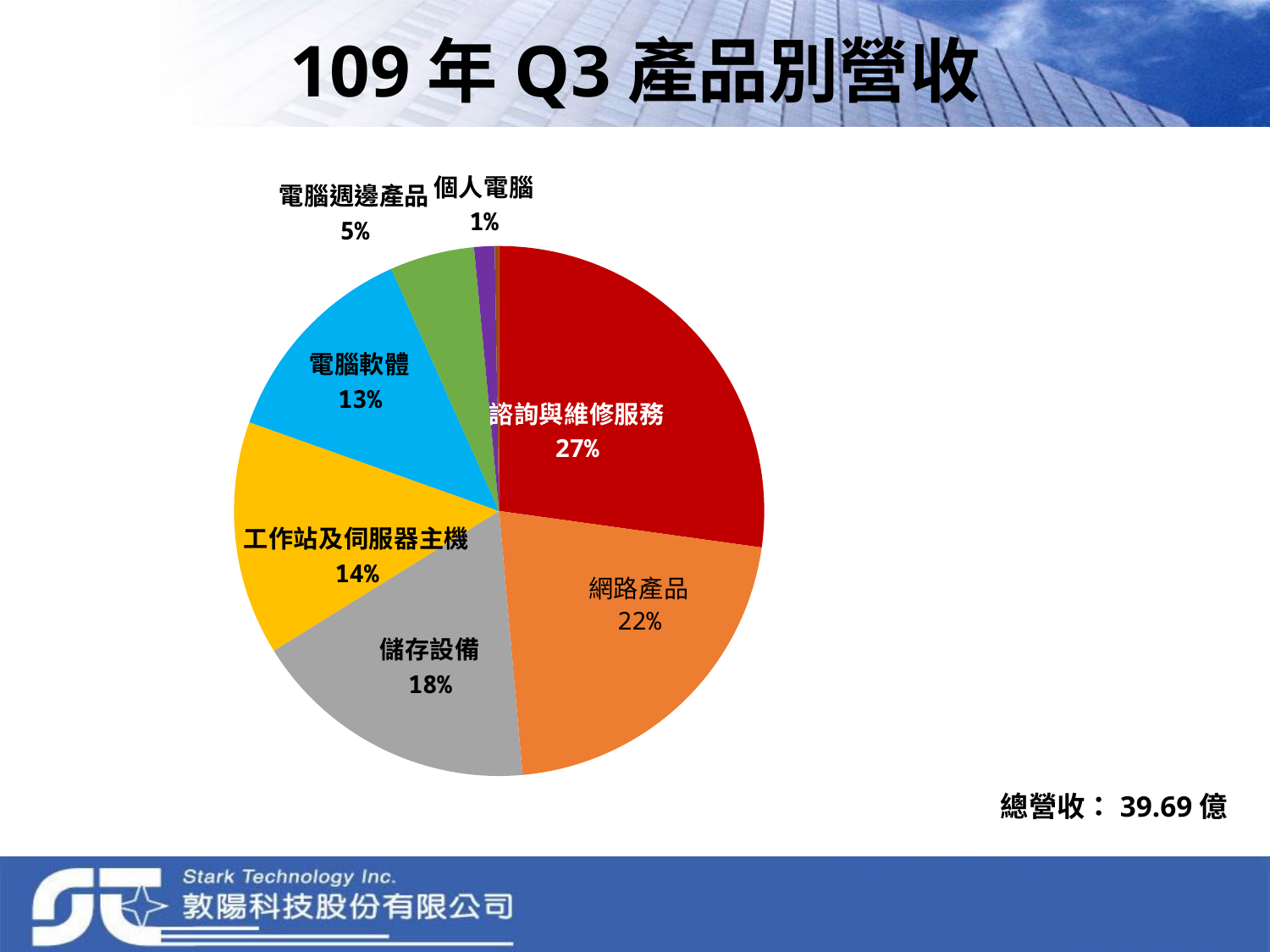
Which product category has the largest share of revenue? 諮詢與維修服務 What kind of chart is shown on the slide? pie chart What percentage is shown for 工作站及伺服器主機? 14% Which labelled product category has the smallest share of revenue? 個人電腦 Which has a larger share, 電腦軟體 or 工作站及伺服器主機? 工作站及伺服器主機 What share of revenue does 諮詢與維修服務 account for? 27% What is the title of the chart on the slide? 109 年 Q3 產品別營收 What percentage is shown for 網路產品? 22% What percentage is shown for 儲存設備? 18% How many labelled product categories are shown in the pie chart? 7 What is the difference in percentage points between 諮詢與維修服務 and 網路產品? 5 What percentage is shown for 電腦週邊產品? 5%